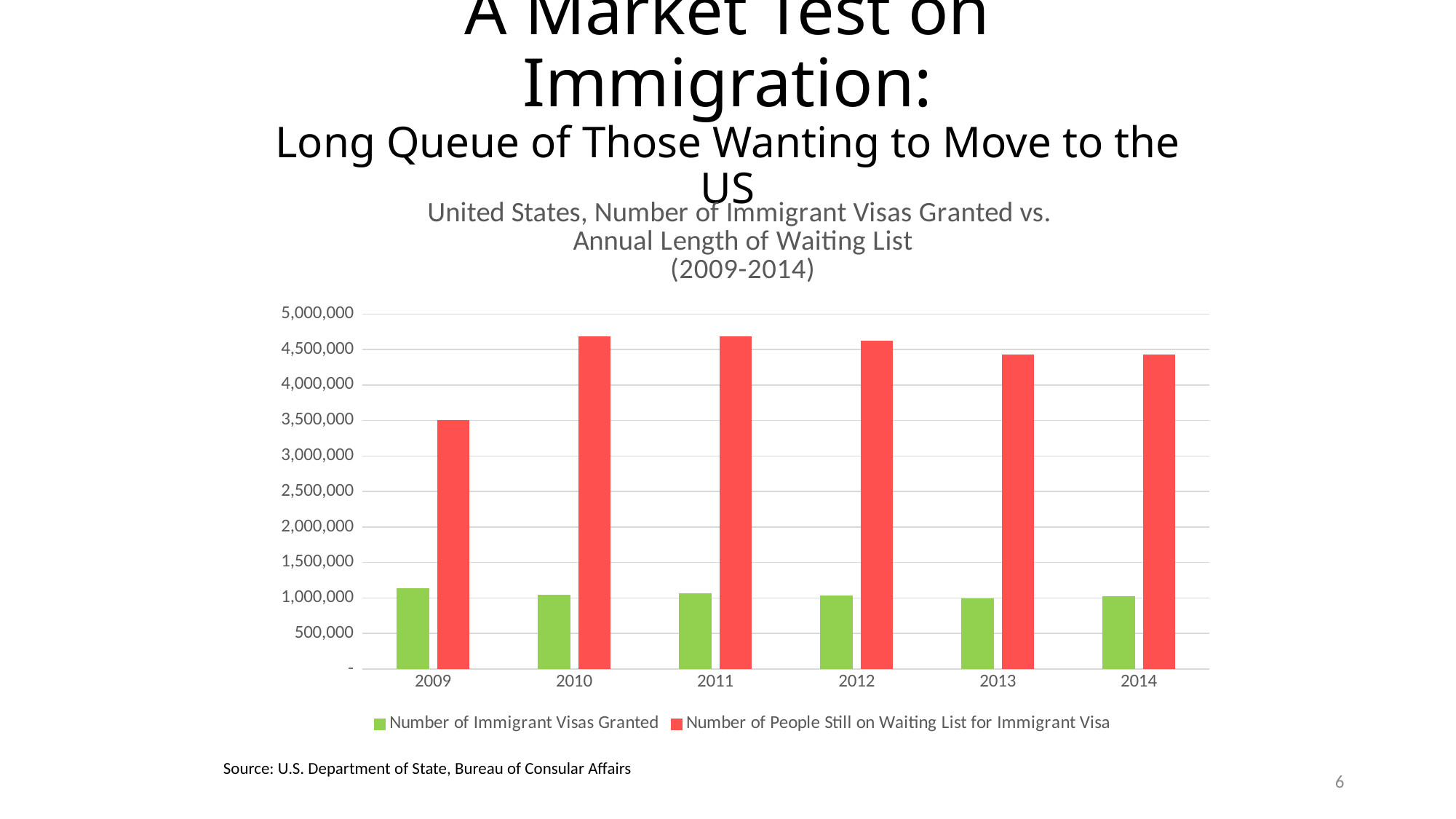
Which year has the highest Number of Immigrant Visas Granted? 2009 What colour are the bars for Number of Immigrant Visas Granted? green How many series does the legend list? 2 What kind of chart is shown on the slide? bar chart Which year has the lowest Number of People Still on Waiting List for Immigrant Visa? 2009 Is the Number of People Still on Waiting List for Immigrant Visa in 2009 greater or less than 4,000,000? less Which is larger in 2012: the Number of Immigrant Visas Granted or the Number of People Still on Waiting List for Immigrant Visa? Number of People Still on Waiting List for Immigrant Visa Is the Number of Immigrant Visas Granted in 2009 greater or less than 1,000,000? greater Which is larger: the Number of People Still on Waiting List for Immigrant Visa in 2011 or in 2013? 2011 Is the Number of People Still on Waiting List for Immigrant Visa in 2010 greater or less than 4,500,000? greater How many years are shown on the x axis? 6